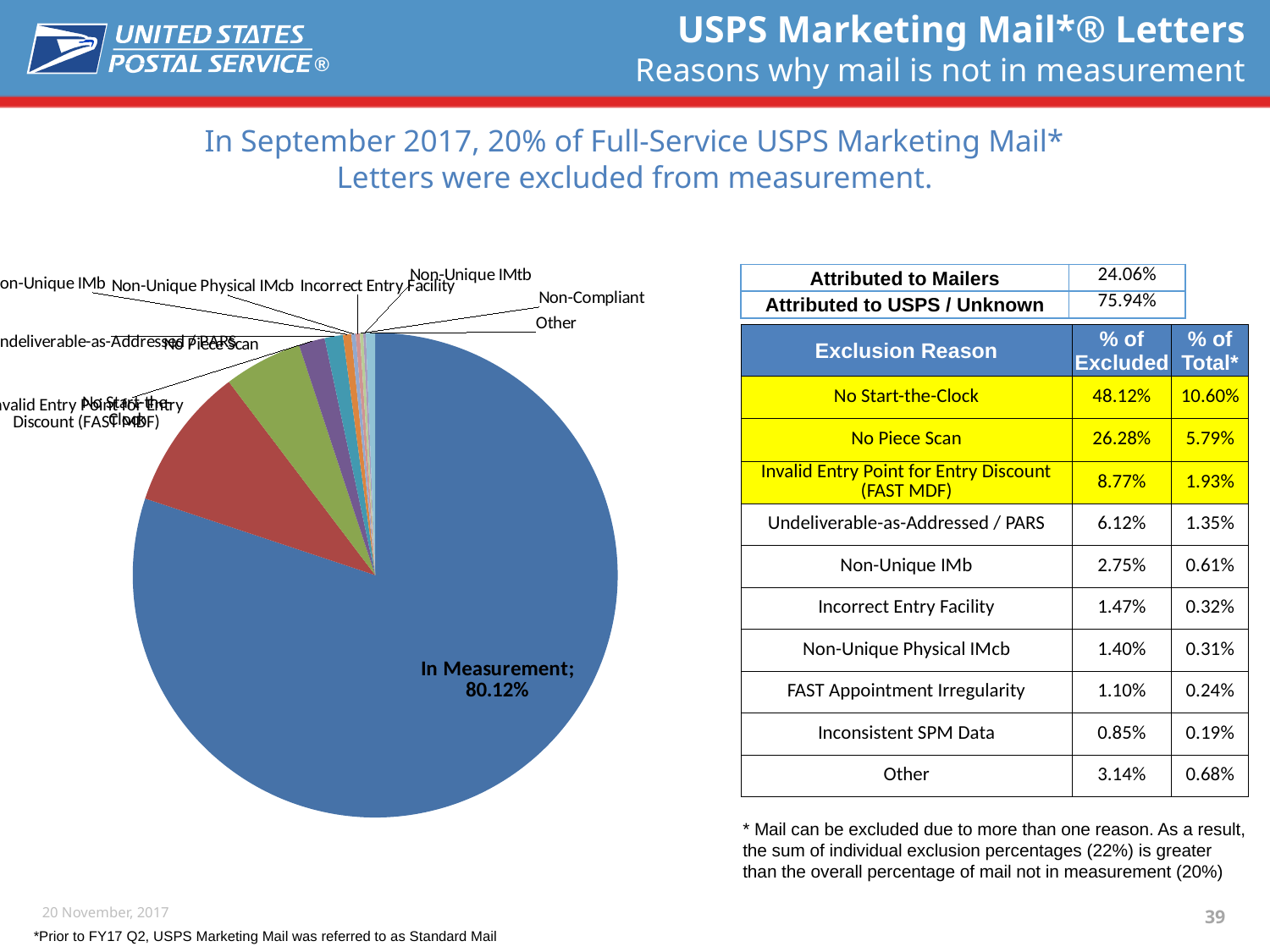
Which is larger in the pie chart, the In Measurement slice or the Non-Compliant slice? In Measurement What percentage of mail is shown as In Measurement in the pie chart? 80.12% Which slice of the pie chart is the largest? In Measurement Which is larger in the pie chart, the In Measurement slice or the Other slice? In Measurement Which slice of the pie chart has its value printed as a data label? In Measurement What colour is the In Measurement slice of the pie chart? blue What kind of chart is shown on the slide? pie chart What share of the pie does the In Measurement slice represent? 80.12%